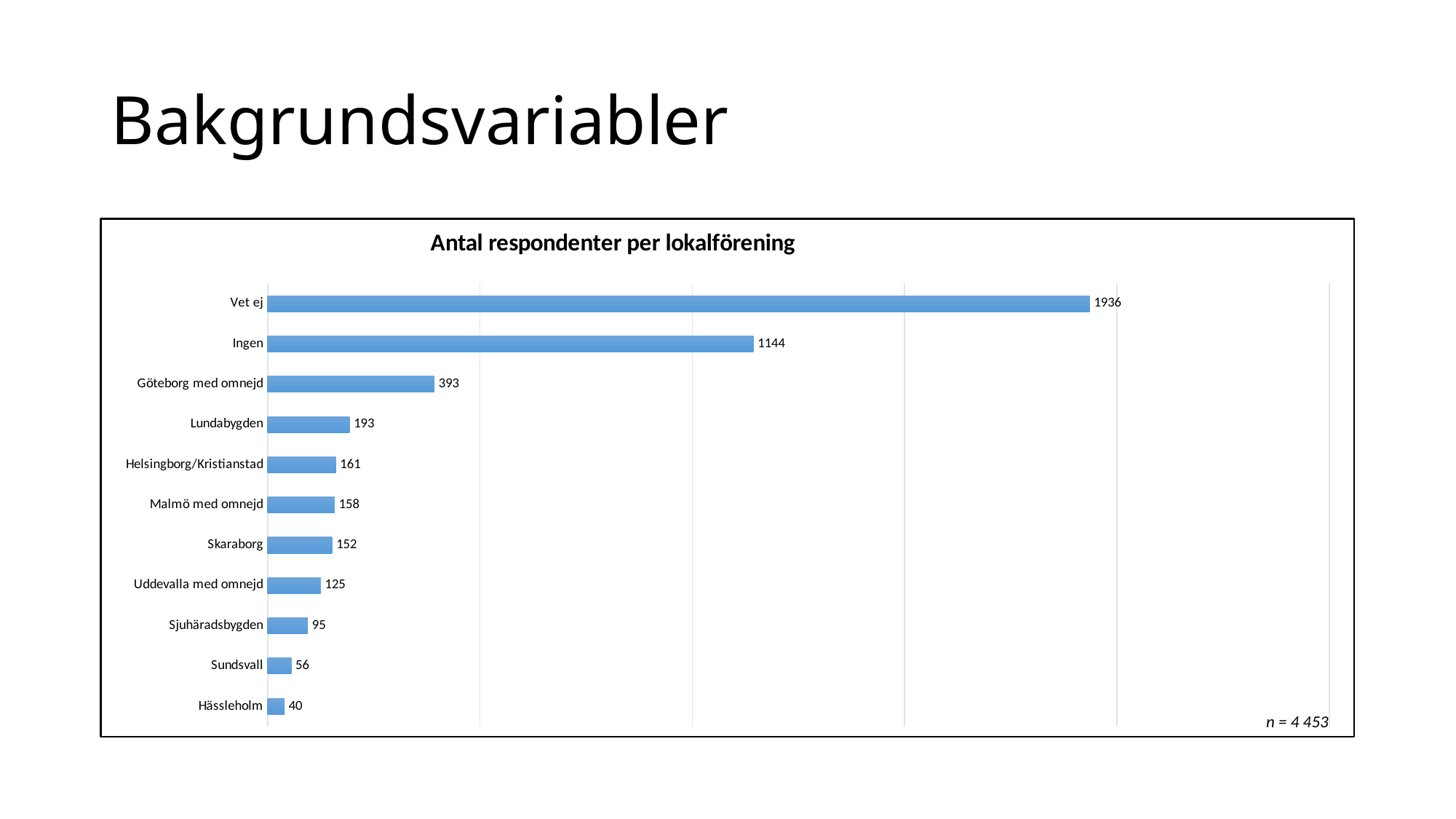
What is the value for Ingen? 1144 Which is larger, the value for Göteborg med omnejd or the value for Lundabygden? Göteborg med omnejd Which category has the lowest value? Hässleholm What is the value for Göteborg med omnejd? 393 Which category has the highest value? Vet ej How many categories are shown in the chart? 11 What is the value for Sjuhäradsbygden? 95 What kind of chart is shown on the slide? Bar chart What is the title of the chart? Antal respondenter per lokalförening Which is larger, the value for Sundsvall or the value for Hässleholm? Sundsvall What is the difference between the values for Vet ej and Ingen? 792 What is the difference between the values for Lundabygden and Uddevalla med omnejd? 68